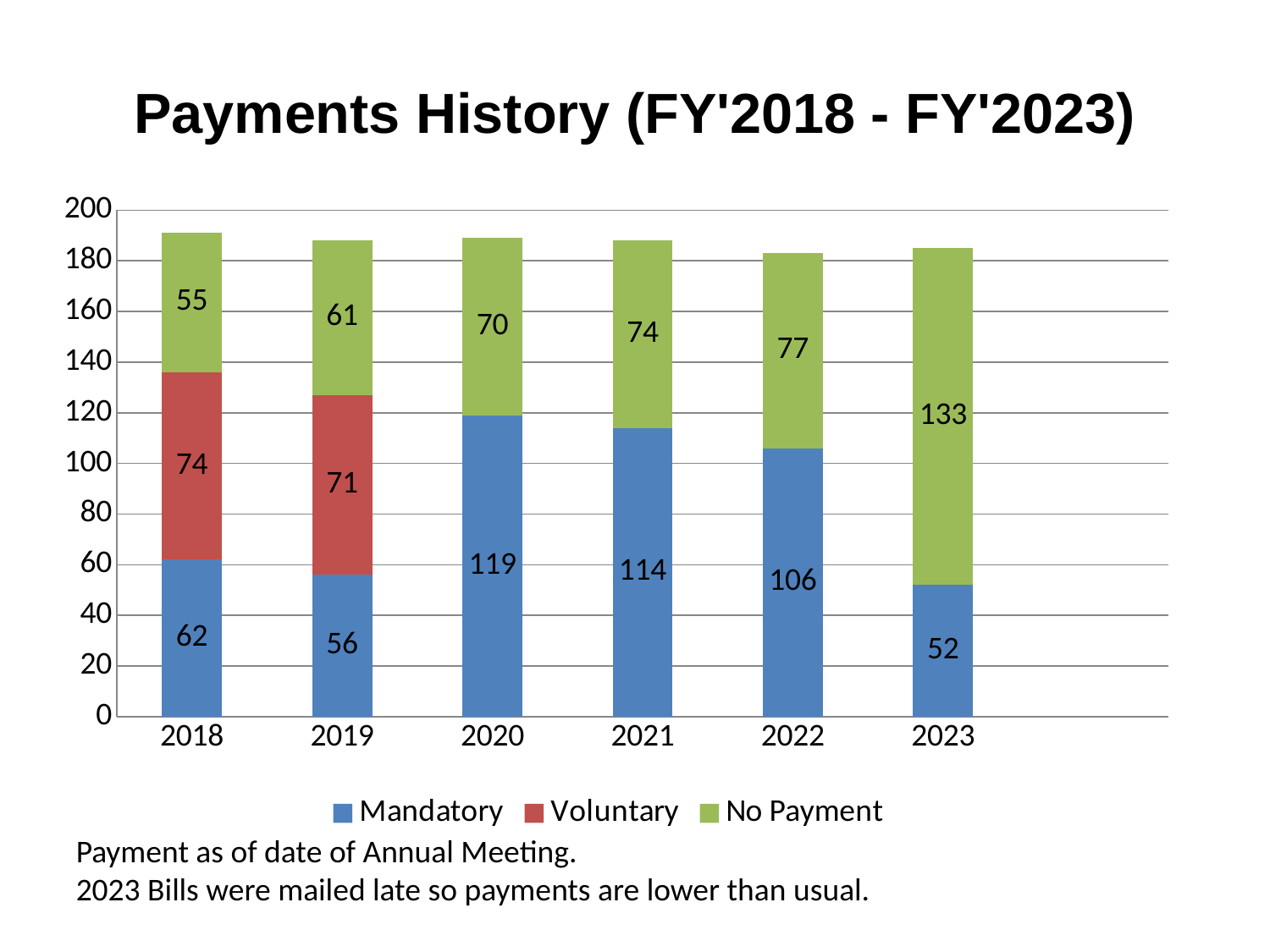
What is the No Payment value for 2023? 133 Which year has the lowest Mandatory value? 2023 Do the No Payment values rise or fall from 2018 to 2023? Rise What is the Voluntary value for 2019? 71 What kind of chart is shown on the slide? Stacked bar chart What is the Mandatory value for 2020? 119 How many series does the legend list? 3 What is the total of the stacked bar for 2018? 191 Which year has the larger Mandatory value, 2021 or 2022? 2021 What is the difference between the No Payment values for 2023 and 2022? 56 How many years are shown on the x axis? 6 Which year has the highest Mandatory value? 2020